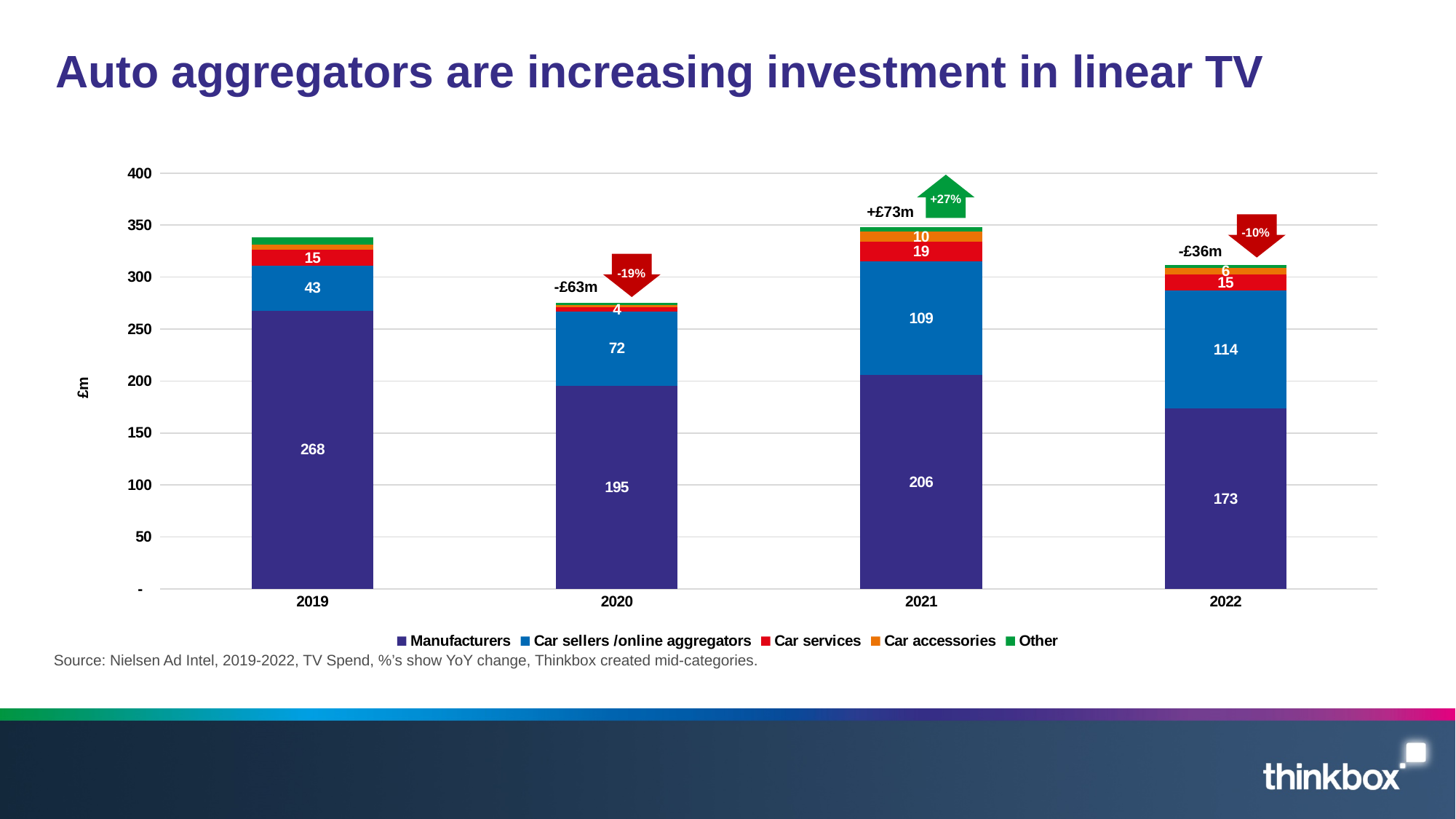
In which year is the Car sellers /online aggregators value lowest? 2019 What kind of chart is shown on the slide? stacked bar chart What is the difference between the Car sellers /online aggregators values for 2022 and 2019? 71 Do the Car sellers /online aggregators values rise or fall from 2019 to 2022? rise Which year has the larger Manufacturers value, 2020 or 2021? 2021 What is the value for Car services in 2021? 19 How many series does the legend list? 5 In which year is the Manufacturers value highest? 2019 How many years are shown on the x axis? 4 Is the total height of the 2021 bar greater or less than 300? greater What is the value for Manufacturers in 2019? 268 What is the value for Car sellers /online aggregators in 2021? 109